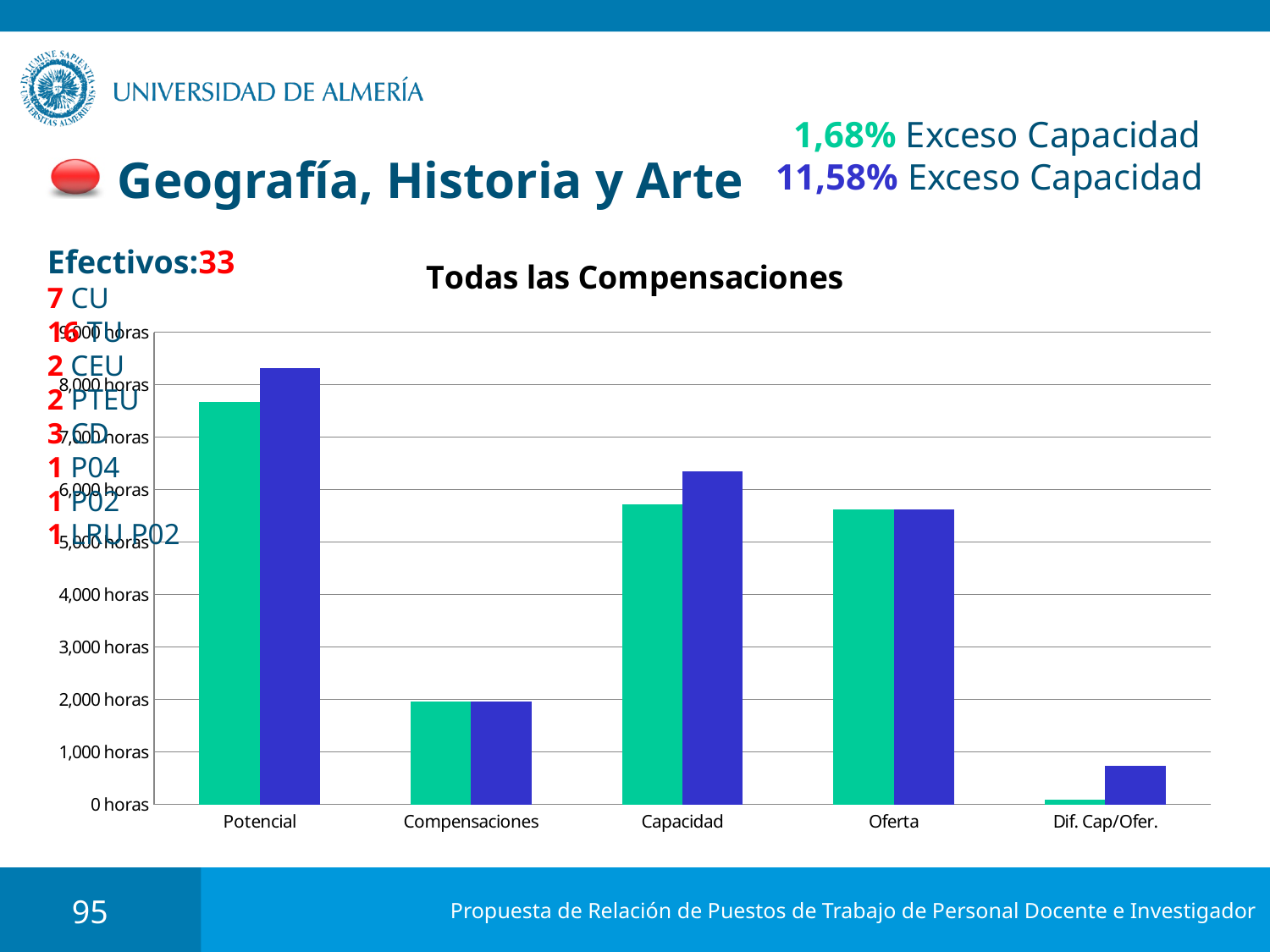
Is the green bar for Oferta greater or less than 6,000 horas? less What kind of chart is shown under the title 'Todas las Compensaciones'? bar chart Is the blue bar for Potencial greater or less than 8,000 horas? greater Is the blue bar for Capacidad greater or less than 6,000 horas? greater Which category has the shortest bars in the chart? Dif. Cap/Ofer. How many categories are shown on the x axis of the chart? 5 Which category has the tallest bars in the chart? Potencial Which is larger, the blue bar for Capacidad or the blue bar for Oferta? Capacidad What is the title of the chart? Todas las Compensaciones